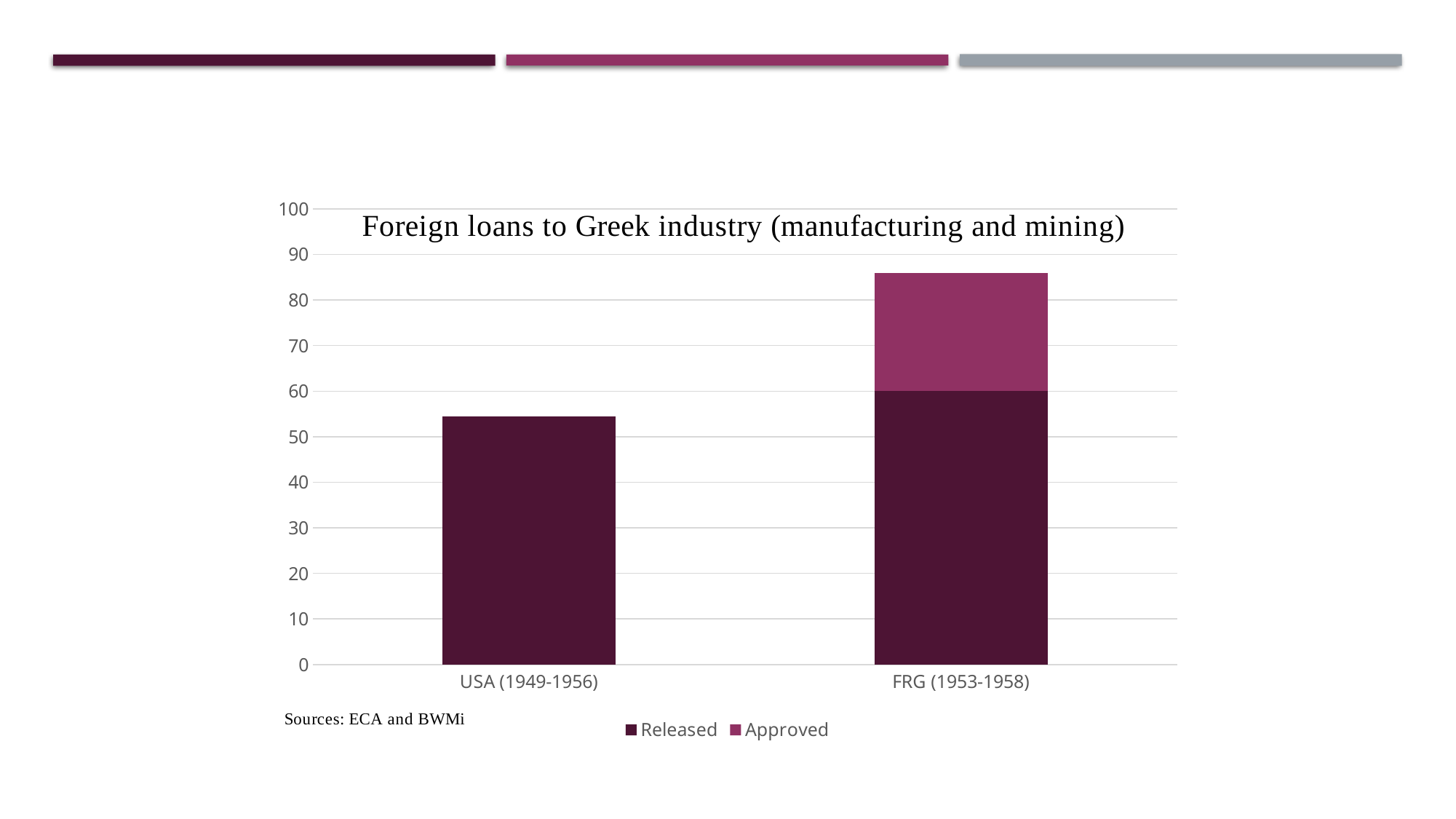
Which series are listed in the chart's legend? Released and Approved Is the Released value for USA (1949-1956) greater or less than 60? less Is the total bar for FRG (1953-1958) greater or less than 90? less Is the total bar for FRG (1953-1958) greater or less than 80? greater Which category has the lowest total bar? USA (1949-1956) Which category has a larger Released value, USA (1949-1956) or FRG (1953-1958)? FRG (1953-1958) How many categories are shown on the x axis of the chart? 2 How many series does the chart's legend list? 2 What kind of chart is shown on the slide? stacked bar chart Which category has the taller total bar, USA (1949-1956) or FRG (1953-1958)? FRG (1953-1958) What is the title of the chart? Foreign loans to Greek industry (manufacturing and mining)